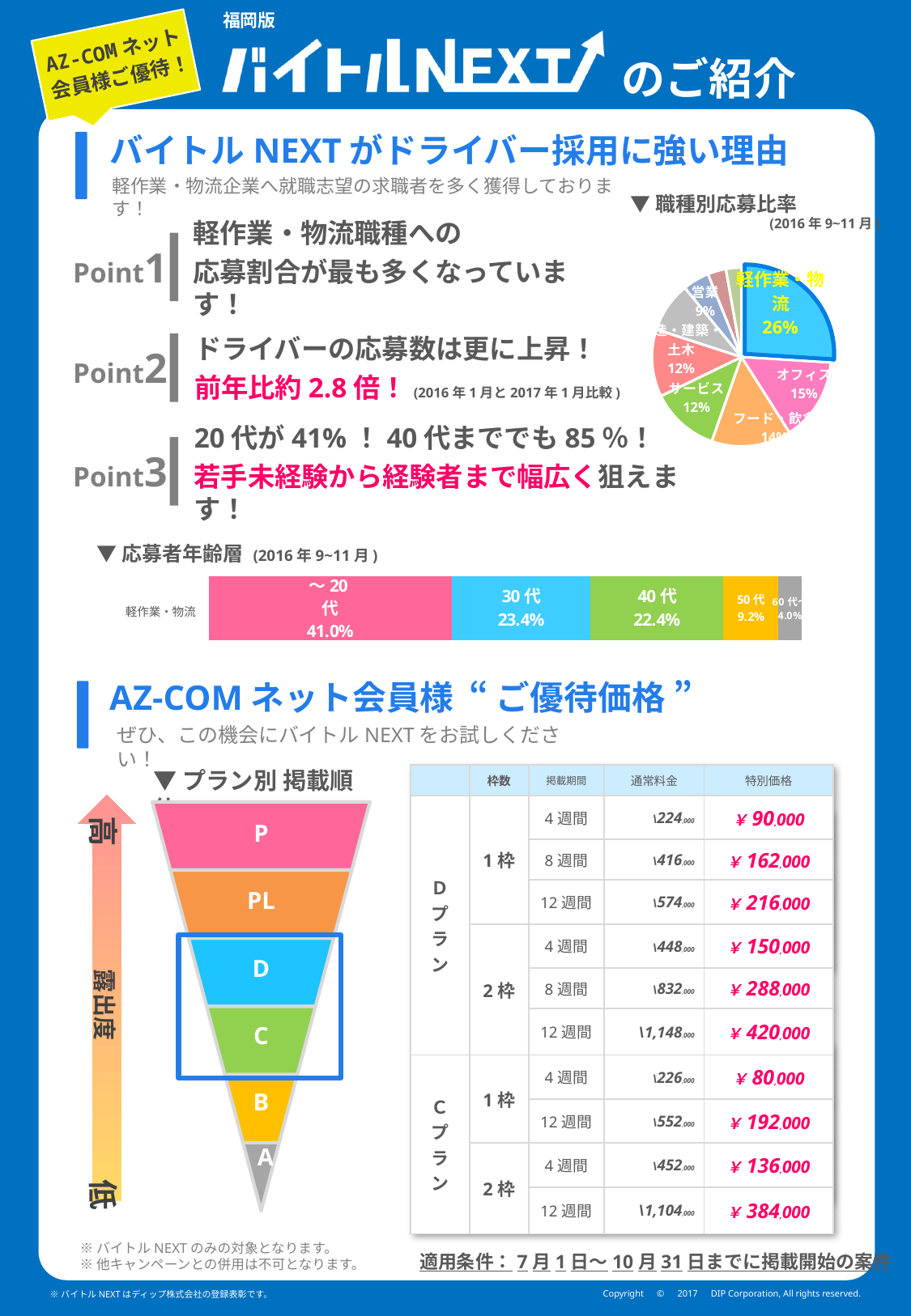
In the 応募者年齢層 bar chart, what is the difference between the 30代 and 40代 values? 1.0 percentage point In the pie chart 職種別応募比率, which category has the largest share? 軽作業・物流 In the pie chart 職種別応募比率, what is the value for 営業? 9% How many age-group segments are shown in the 応募者年齢層 bar chart? 5 In the 応募者年齢層 bar chart, what is the value for 30代? 23.4% In the pie chart 職種別応募比率, how many percentage points larger is 軽作業・物流 than オフィス? 11 percentage points In the 応募者年齢層 bar chart, which age group has the smallest share? 60代～ In the 応募者年齢層 bar chart, what is the value for ～20代? 41.0% In the pie chart 職種別応募比率, what is the value for 軽作業・物流? 26% In the pie chart 職種別応募比率, what is the value for オフィス? 15% In the pie chart 職種別応募比率, which is larger, サービス or 営業? サービス What kind of chart is the 職種別応募比率 chart? Pie chart